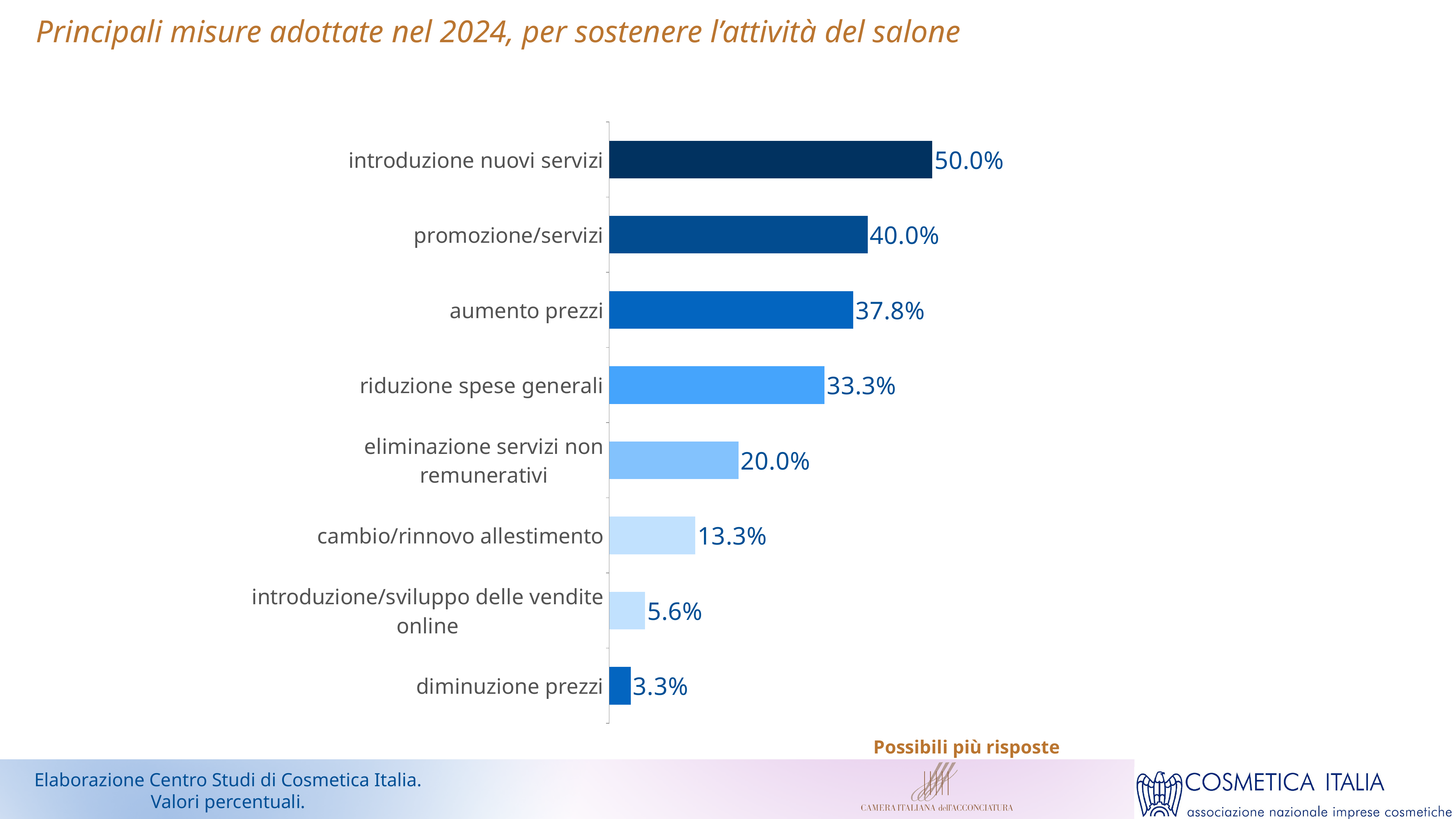
What kind of chart is shown on the slide? bar chart What is the value for 'introduzione nuovi servizi'? 50.0% Which category has the lowest value? diminuzione prezzi What is the title of the chart on the slide? Principali misure adottate nel 2024, per sostenere l'attività del salone How many categories are shown in the chart? 8 What is the value for 'aumento prezzi'? 37.8% What is the difference between 'introduzione nuovi servizi' and 'diminuzione prezzi'? 46.7% What is the value for 'introduzione/sviluppo delle vendite online'? 5.6% What is the difference between 'promozione/servizi' and 'riduzione spese generali'? 6.7% Which category has the highest value? introduzione nuovi servizi What is the value for 'eliminazione servizi non remunerativi'? 20.0% Which is larger, 'cambio/rinnovo allestimento' or 'eliminazione servizi non remunerativi'? eliminazione servizi non remunerativi